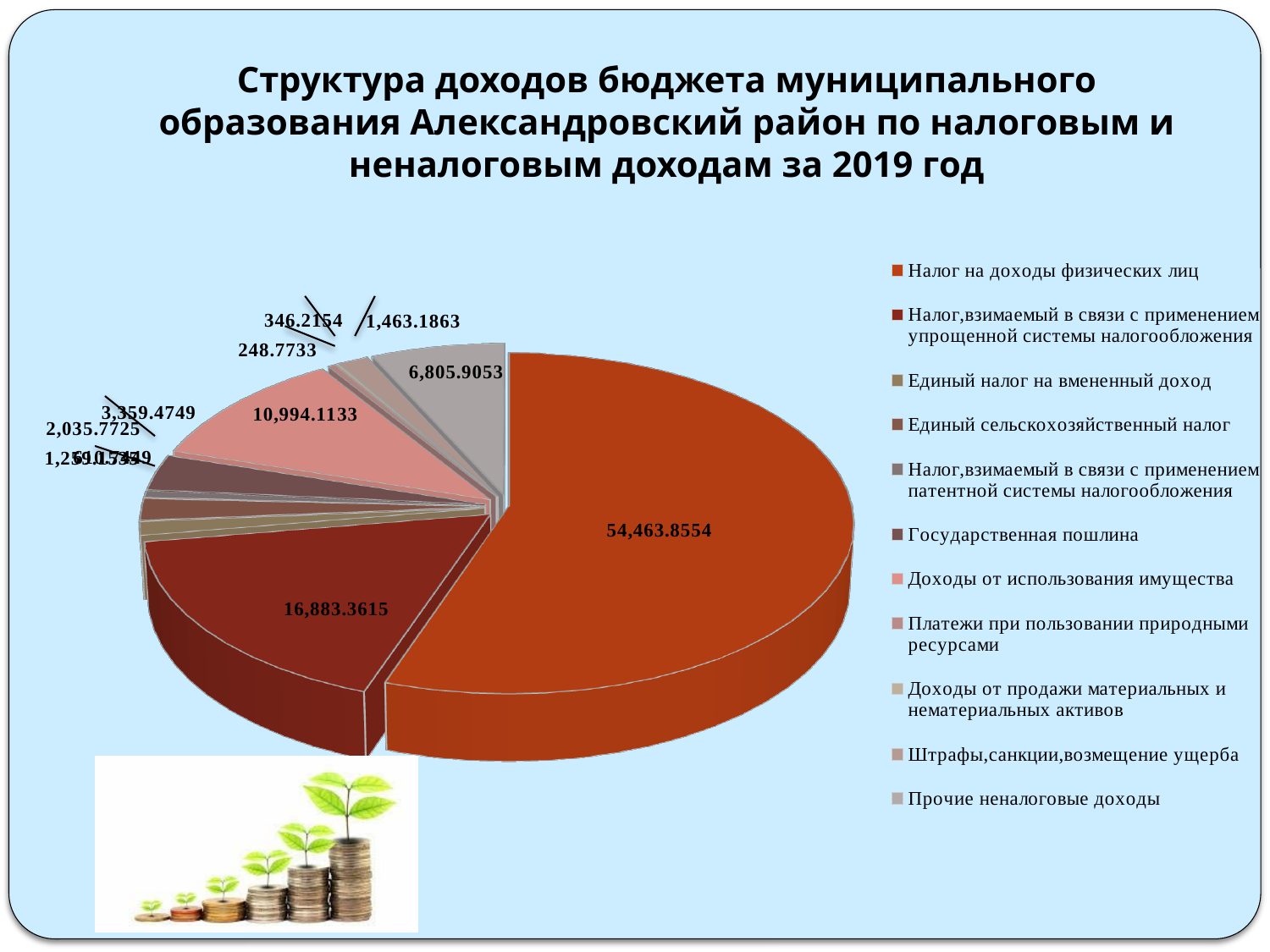
Which category has the largest slice of the pie chart? Налог на доходы физических лиц What is the value shown for Налог, взимаемый в связи с применением упрощенной системы налогообложения? 16,883.3615 What is the value shown for Налог на доходы физических лиц? 54,463.8554 What is the value shown for Прочие неналоговые доходы? 6,805.9053 Which legend entry is shown in grey, the last one in the legend? Прочие неналоговые доходы What is the value shown for Доходы от использования имущества? 10,994.1133 Which is larger: the value for Доходы от использования имущества or the value for Прочие неналоговые доходы? Доходы от использования имущества What kind of chart is shown on the slide? Pie chart How many categories does the legend of the pie chart list? 11 What is the difference between the value for Налог на доходы физических лиц and the value for Налог, взимаемый в связи с применением упрощенной системы налогообложения? 37,580.4939 What is the difference between the value for Доходы от использования имущества and the value for Прочие неналоговые доходы? 4,188.2080 For which year does the chart title say the budget income structure is shown? 2019